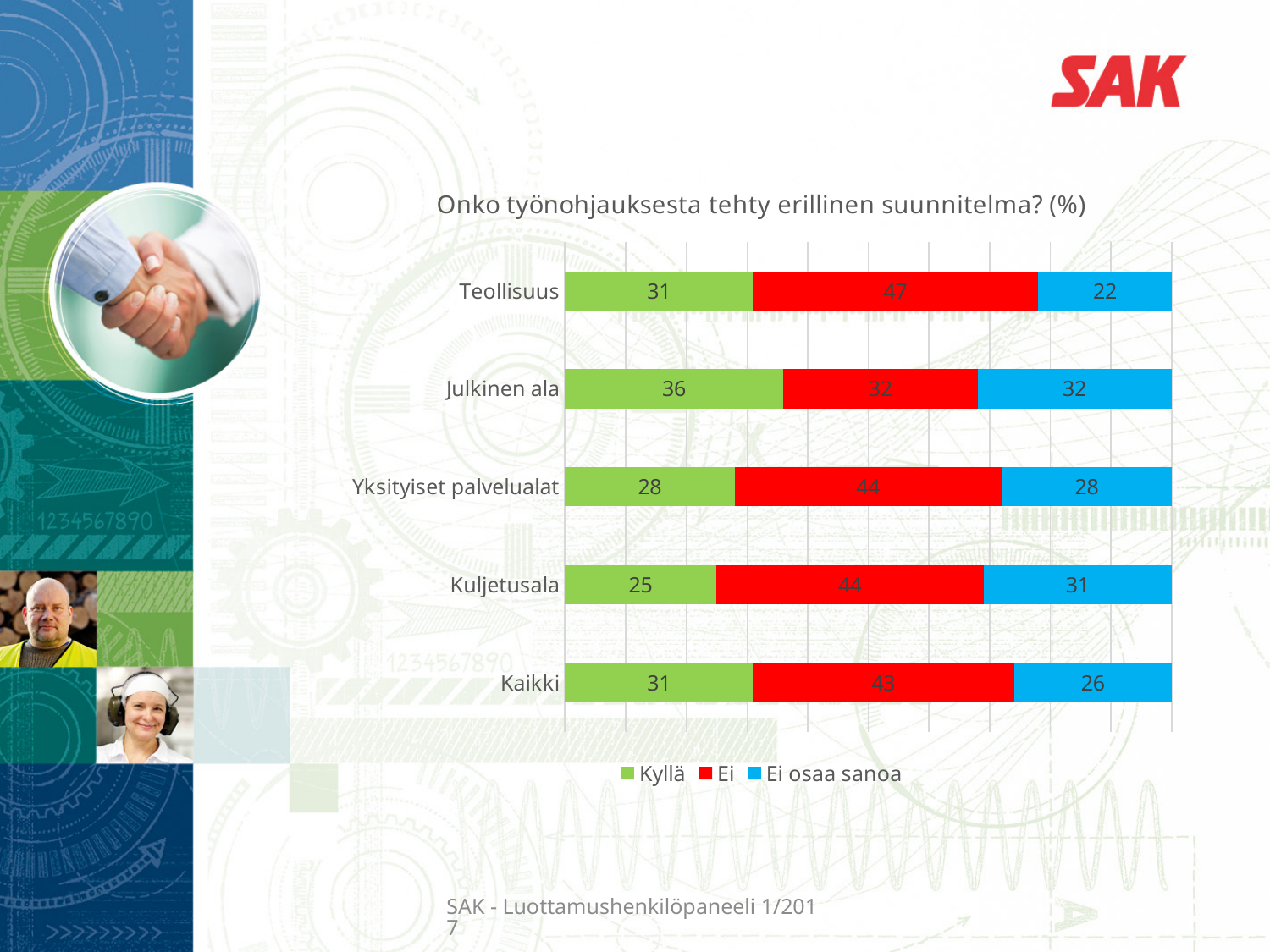
Which is larger: the Kyllä value for Julkinen ala or the Kyllä value for Yksityiset palvelualat? Julkinen ala What is the value for Kyllä in the Teollisuus bar? 31 Which category has the lowest Kyllä value? Kuljetusala What is the value for Ei osaa sanoa in the Kuljetusala bar? 31 How many series does the legend list? 3 What is the difference between the Ei value for Teollisuus and the Ei value for Kaikki? 4 What kind of chart is shown on the slide? Stacked bar chart What is the total of the Julkinen ala bar? 100 What is the title of the chart? Onko työnohjauksesta tehty erillinen suunnitelma? (%) How many categories are shown on the chart? 5 What is the value for Ei in the Julkinen ala bar? 32 Which category has the highest Ei value? Teollisuus